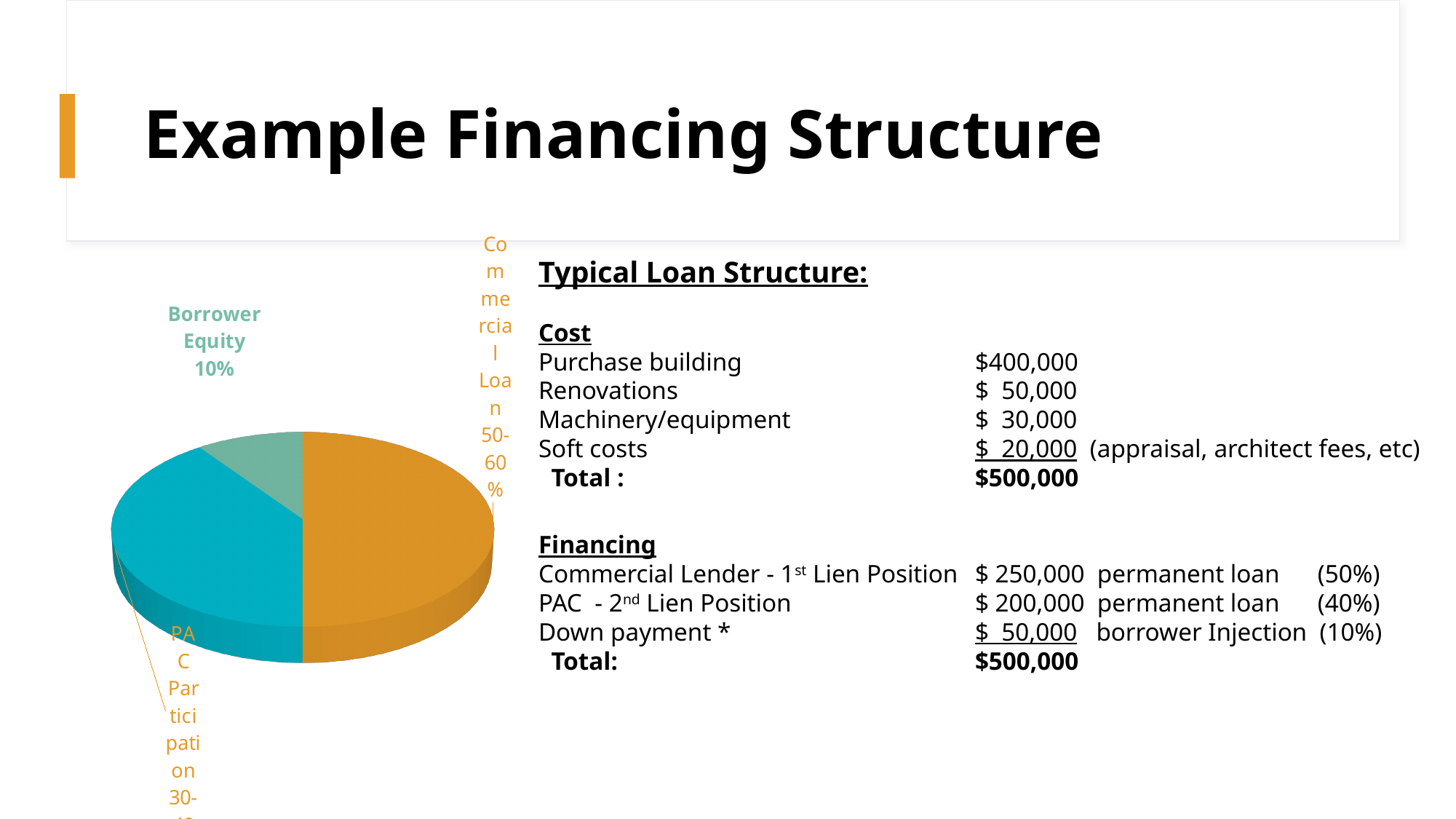
What kind of chart is shown on the slide? pie chart Which slice of the pie chart is the largest? Commercial Loan How many slices does the pie chart have? 3 What share of the pie does Borrower Equity represent? 10% Which is larger in the pie chart, the PAC Participation slice or the Borrower Equity slice? PAC Participation Which slice of the pie chart is the smallest? Borrower Equity Which slice of the pie chart is coloured teal? PAC Participation What percentage is shown for Borrower Equity in the pie chart? 10% What percentage range is shown for the Commercial Loan slice in the pie chart? 50-60% Which is larger in the pie chart, the Commercial Loan slice or the Borrower Equity slice? Commercial Loan What colour is the Commercial Loan slice in the pie chart? orange